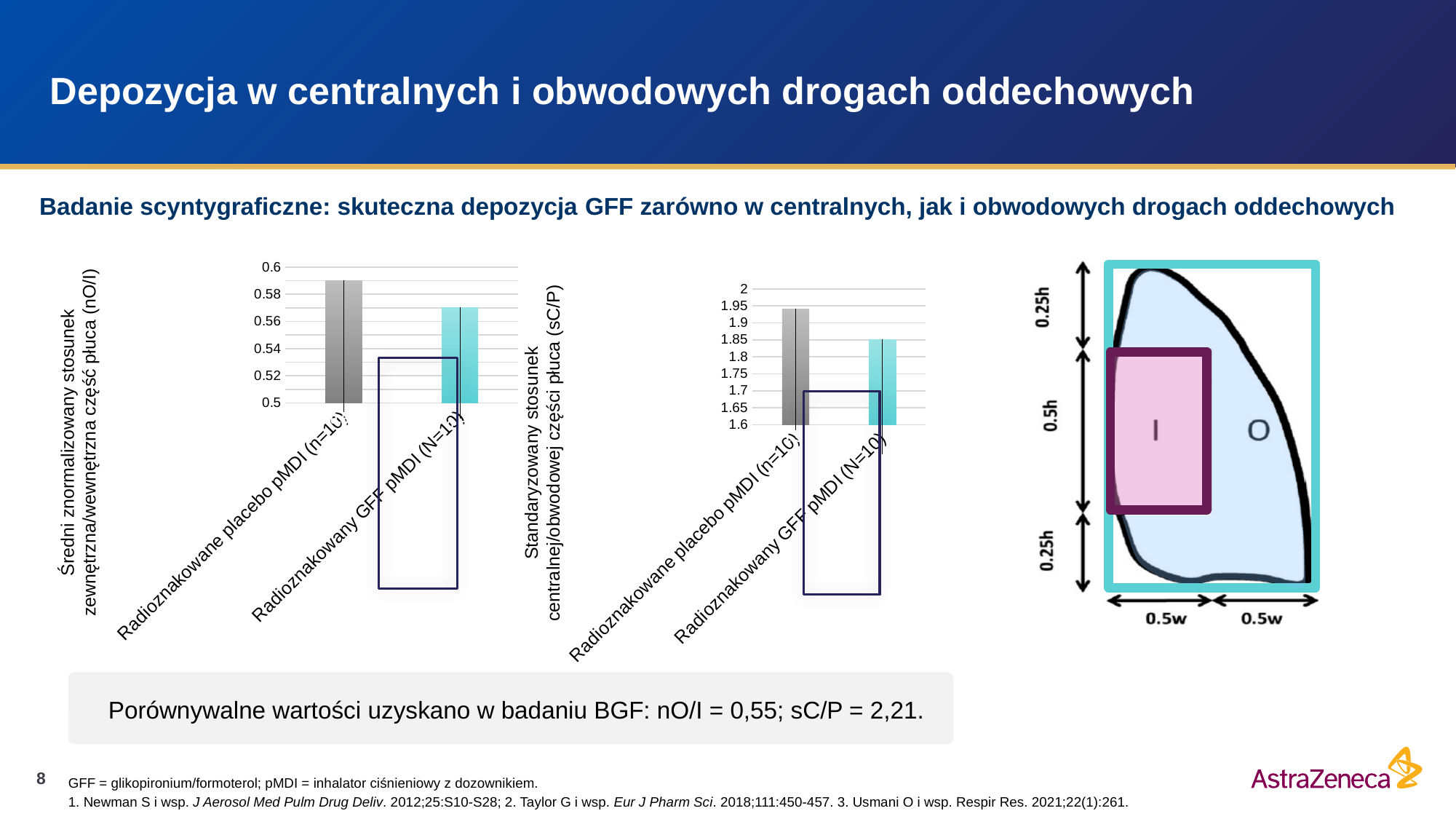
In the left chart (nO/I), which category has the higher value? Radioznakowane placebo pMDI (n=10) How many categories does the right chart (sC/P) show? 2 In the right chart (sC/P), is the value for Radioznakowane placebo pMDI (n=10) greater or less than 1.9? greater In the right chart (sC/P), is the value for Radioznakowany GFF pMDI (N=10) greater or less than 1.9? less What kind of chart is the left chart (nO/I)? bar chart In the left chart (nO/I), is the value for Radioznakowane placebo pMDI (n=10) greater or less than 0.6? less In the right chart (sC/P), which is larger: the value for Radioznakowane placebo pMDI (n=10) or for Radioznakowany GFF pMDI (N=10)? Radioznakowane placebo pMDI (n=10) In the right chart (sC/P), which category has the lower value? Radioznakowany GFF pMDI (N=10) In the left chart (nO/I), what colour is the bar for Radioznakowany GFF pMDI (N=10)? turquoise What is the lowest y-axis tick value shown on the left chart (nO/I)? 0.5 What is the y-axis title of the right chart? Standaryzowany stosunek centralnej/obwodowej części płuca (sC/P)